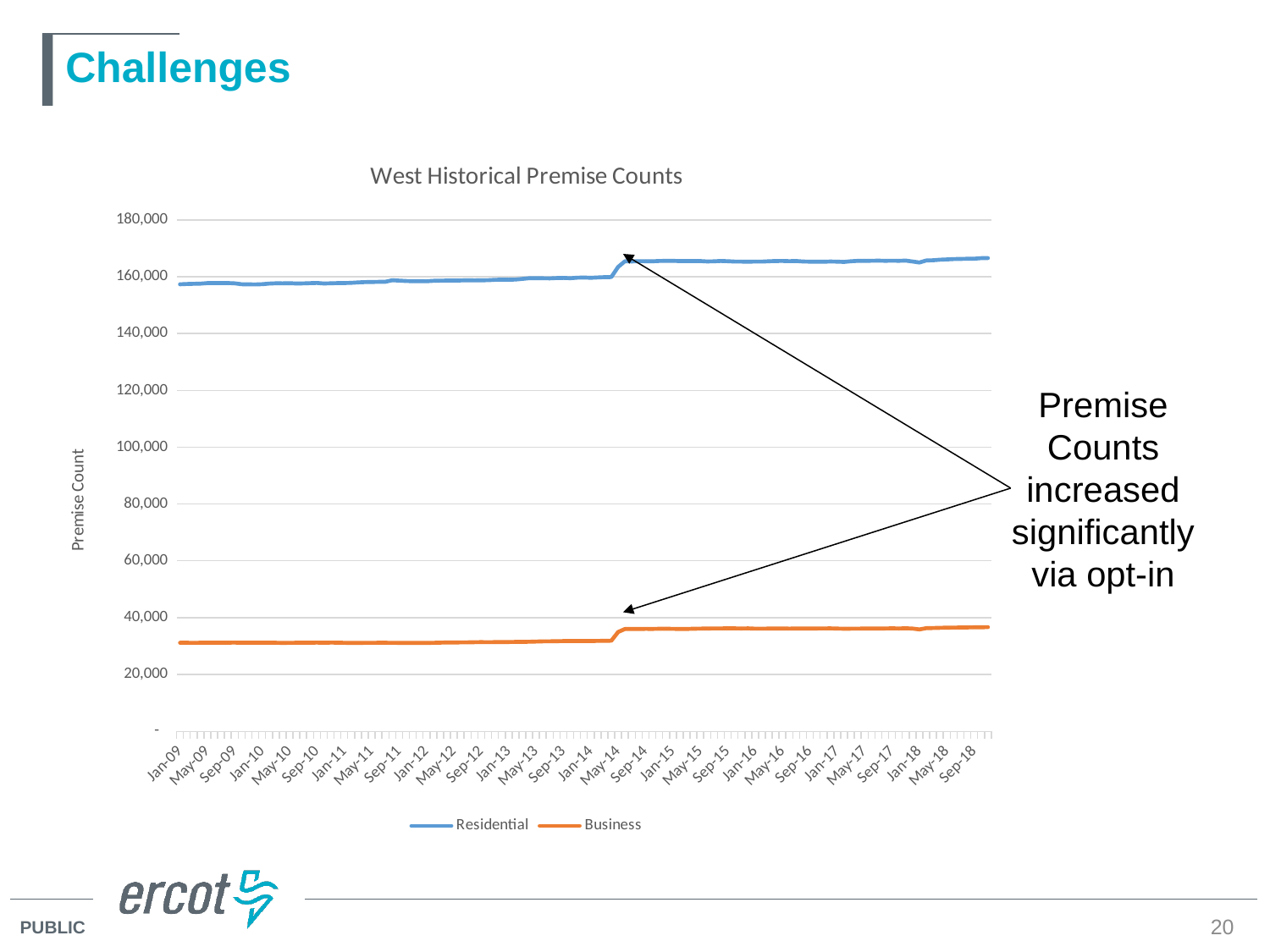
Do the Business premise counts rise or fall overall from Jan-09 to Sep-18? rise Is the Residential value in Jan-09 greater or less than 140,000? greater What is the label on the vertical axis of the chart? Premise Count Do the Residential premise counts rise or fall overall from Jan-09 to Sep-18? rise Is the Business value in Sep-18 greater or less than 20,000? greater What is the title of the chart? West Historical Premise Counts Is the Residential value in Jan-09 greater or less than 160,000? less What kind of chart is shown on the slide? Line chart Which series has the higher values throughout the chart, Residential or Business? Residential How many series does the legend of the chart list? 2